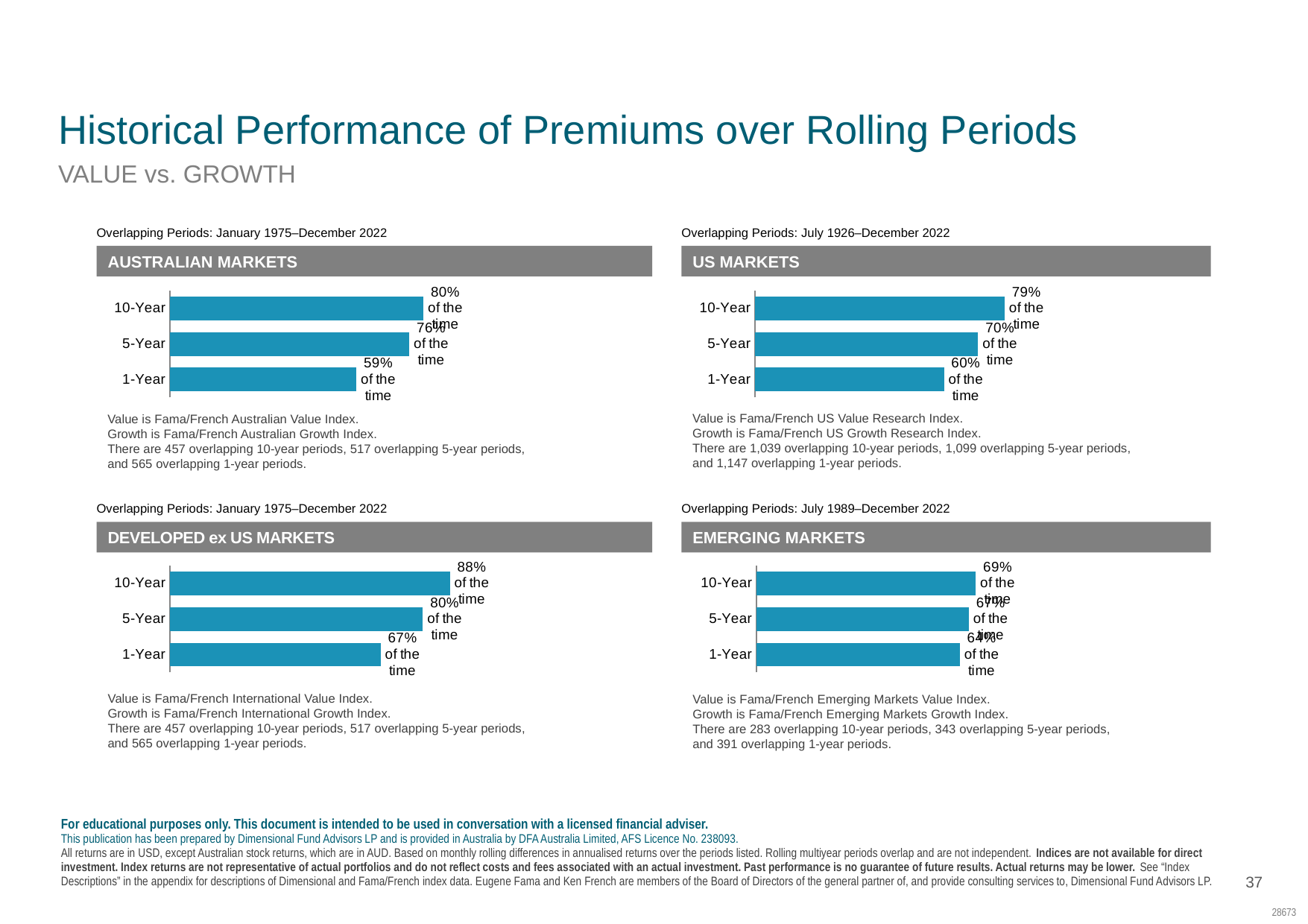
In the US Markets chart, what is the value for 1-Year? 60% What overlapping period range is shown above the US Markets chart? July 1926–December 2022 In the US Markets chart, what is the difference between the 10-Year and 1-Year values? 19% What type of chart is used for the Emerging Markets data? Bar chart In the Developed ex US Markets chart, which period has the highest value? 10-Year In the Developed ex US Markets chart, what is the value for 5-Year? 80% In the Emerging Markets chart, what is the value for 1-Year? 64% How many bars are plotted in the US Markets chart? 3 In the Australian Markets chart, which period has the lowest value? 1-Year In the Australian Markets chart, which is larger, the 5-Year value or the 1-Year value? 5-Year In the Australian Markets chart, what is the value for 10-Year? 80% In the Emerging Markets chart, what is the difference between the 10-Year and 5-Year values? 2%